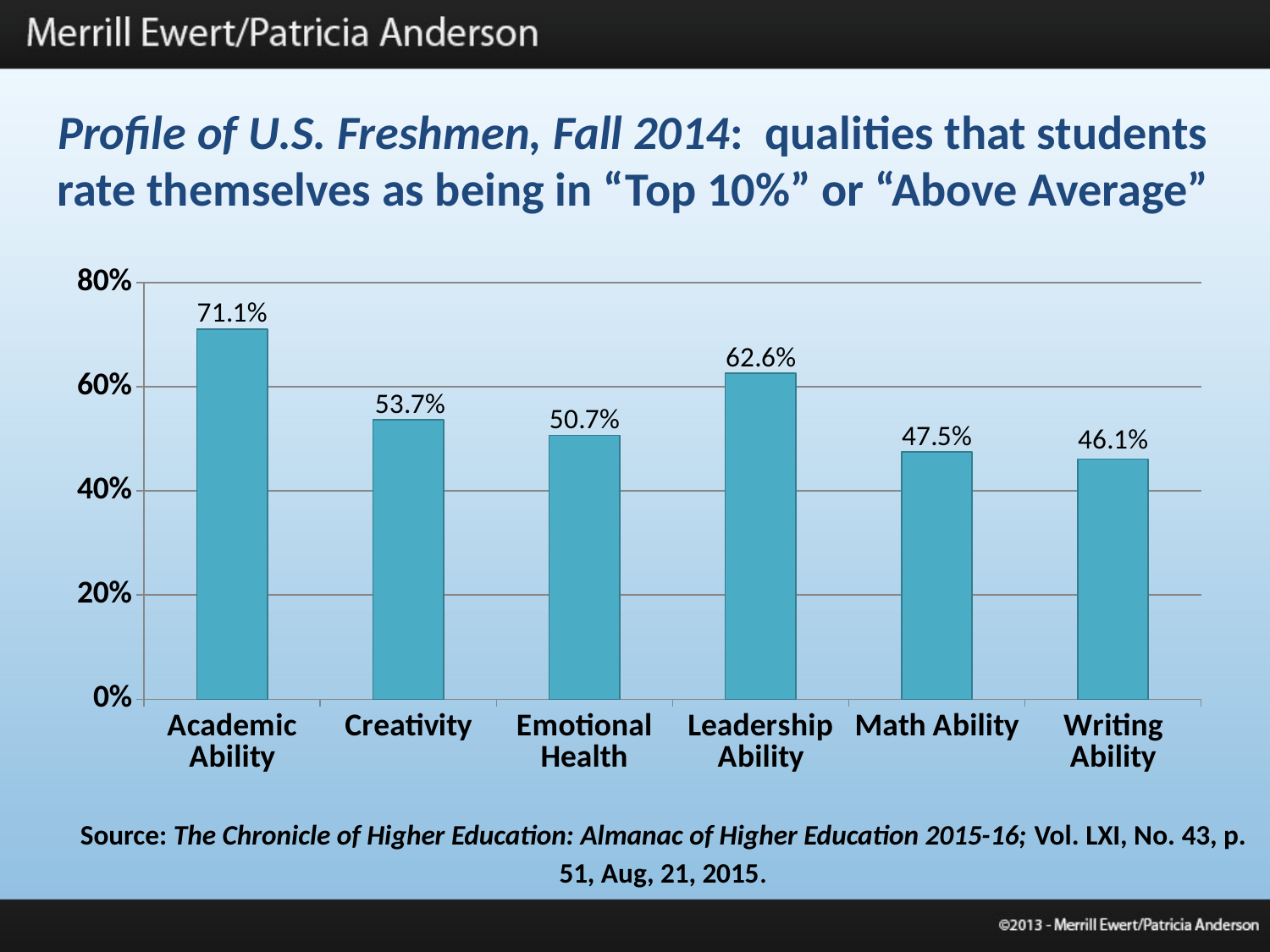
What kind of chart is shown on the slide? bar chart What is the difference between the values for Creativity and Emotional Health? 3.0% What is the value shown for Writing Ability? 46.1% Which quality has the lowest percentage? Writing Ability Is the value for Math Ability greater or less than 60%? less What percentage of freshmen rate themselves as 'Top 10%' or 'Above Average' in Academic Ability? 71.1% What is the highest value labelled on the y axis of the chart? 80% How many qualities are shown on the x axis of the chart? 6 What is the value shown for Leadership Ability? 62.6% Which quality has the highest percentage of students rating themselves in the 'Top 10%' or 'Above Average'? Academic Ability Which is larger, the value for Leadership Ability or the value for Creativity? Leadership Ability What is the difference between the values for Academic Ability and Math Ability? 23.6%